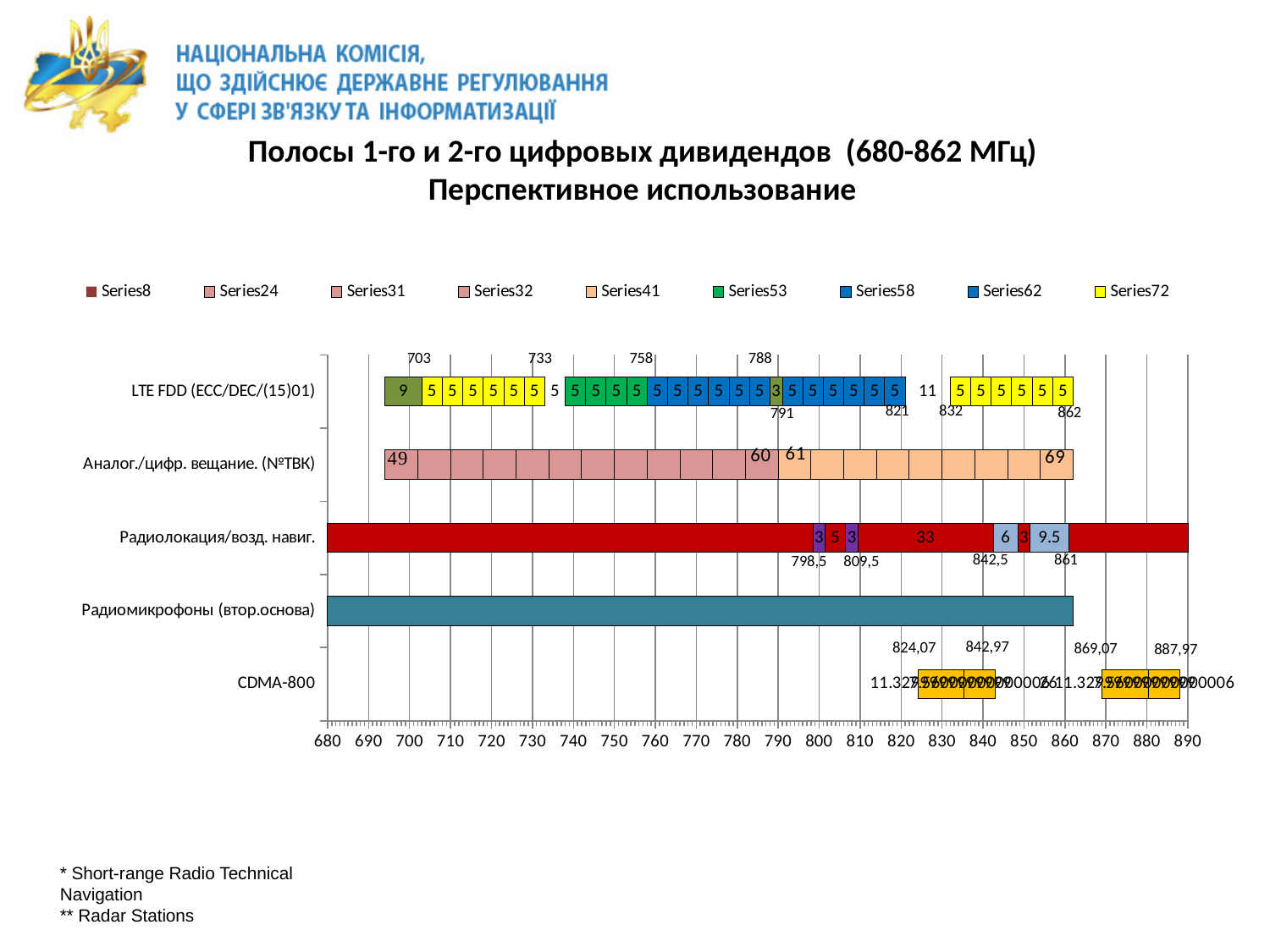
What is the data label on the segment of the LTE FDD bar located between the annotations 821 and 832? 11 How many series does the chart legend list? 9 Is the right end of the Радиомикрофоны (втор.основа) bar greater or less than 850 on the horizontal axis? greater What data label appears at the right end of the Аналог./цифр. вещание. (№ТВК) bar? 69 How many categories are listed on the vertical axis of the chart? 5 What is the data label on the first (leftmost) segment of the LTE FDD (ECC/DEC/(15)01) bar? 9 What is the lowest tick value shown on the horizontal axis? 680 What data label appears at the left end of the Аналог./цифр. вещание. (№ТВК) bar? 49 What is the largest data label shown inside the Радиолокация/возд. навиг. bar? 33 What kind of chart is shown on the slide? bar chart What is the first line of the chart title on the slide? Полосы 1-го и 2-го цифровых дивидендов (680-862 МГц) What frequency value is annotated above the left end of the LTE FDD (ECC/DEC/(15)01) bar? 703